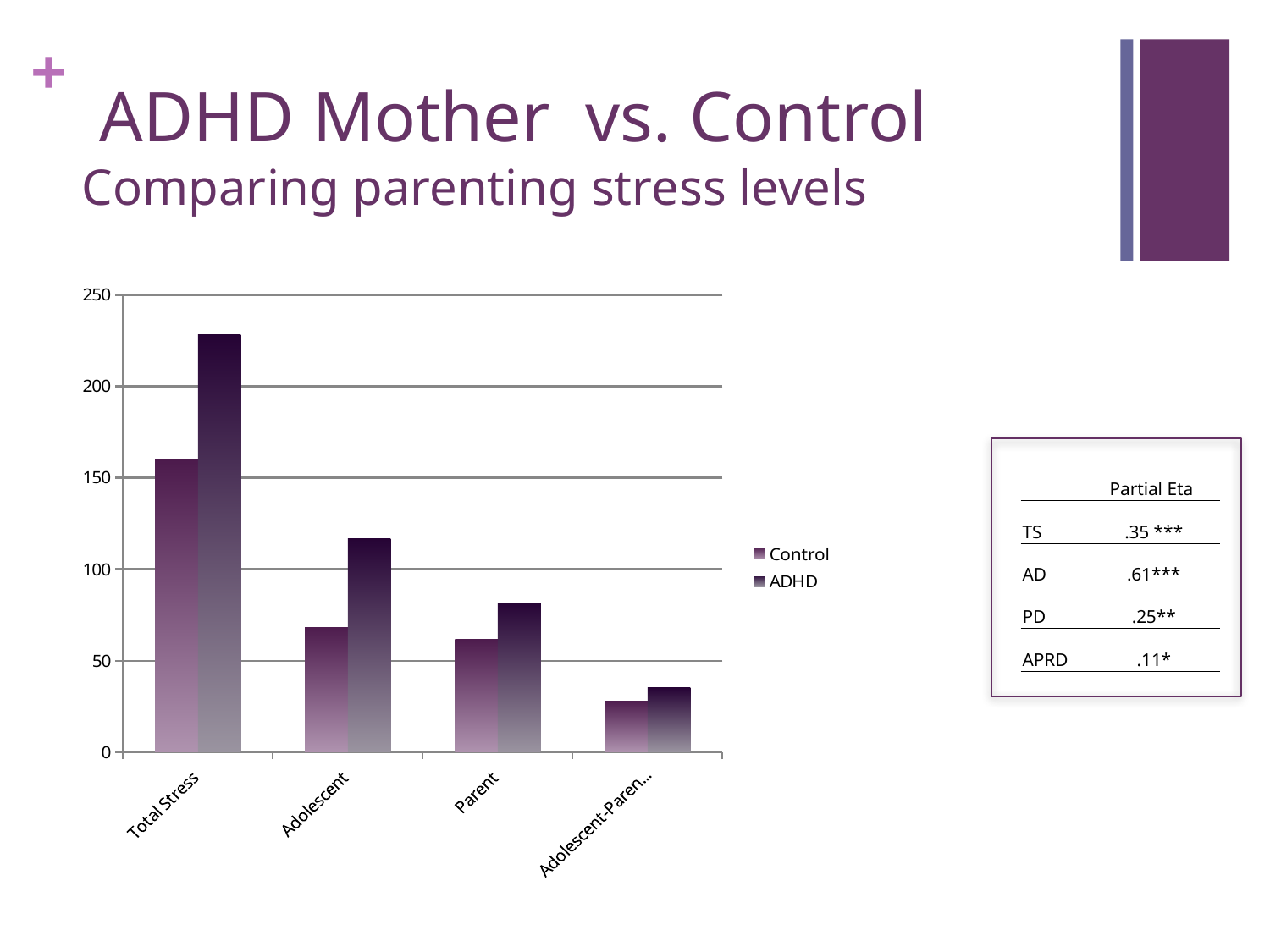
Which category has the highest Control bar? Total Stress Is the ADHD value for Adolescent greater or less than 100? greater Is the ADHD value for Total Stress greater or less than 200? greater Is the Control value for Parent greater or less than 100? less How many categories are shown along the x axis of the chart? 4 How many series does the chart's legend list? 2 What are the two series named in the legend? Control and ADHD Which category has the highest ADHD bar? Total Stress What kind of chart is shown on the slide? bar chart For Total Stress, which series has the larger value, Control or ADHD? ADHD For Adolescent, which series has the larger value, Control or ADHD? ADHD